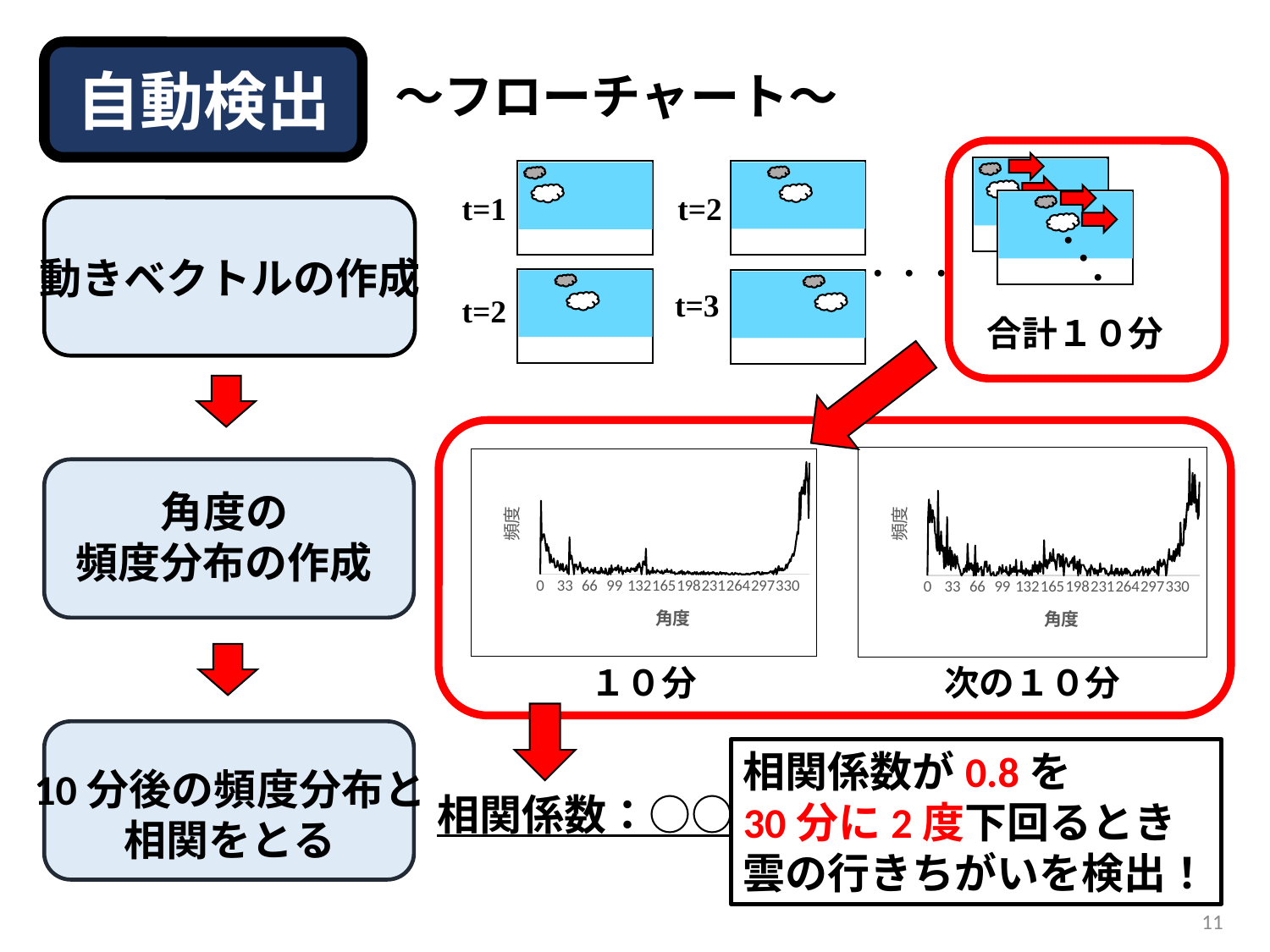
In the left chart labelled 10分, what is the label of the x axis? 角度 How many tick labels are shown on the x axis of the left chart labelled 10分? 11 In the left chart labelled 10分, does the frequency rise or fall as the angle goes from 297 to 330? rises What kind of chart is the left chart labelled 10分? line chart What kind of chart is the right chart labelled 次の10分? line chart In the right chart labelled 次の10分, does the frequency rise or fall as the angle goes from 297 to 330? rises In the right chart labelled 次の10分, is the frequency near angle 0 greater or less than the frequency near angle 198? greater In the right chart labelled 次の10分, what is the label of the y axis? 頻度 In the left chart labelled 10分, is the frequency near angle 330 greater or less than the frequency near angle 165? greater